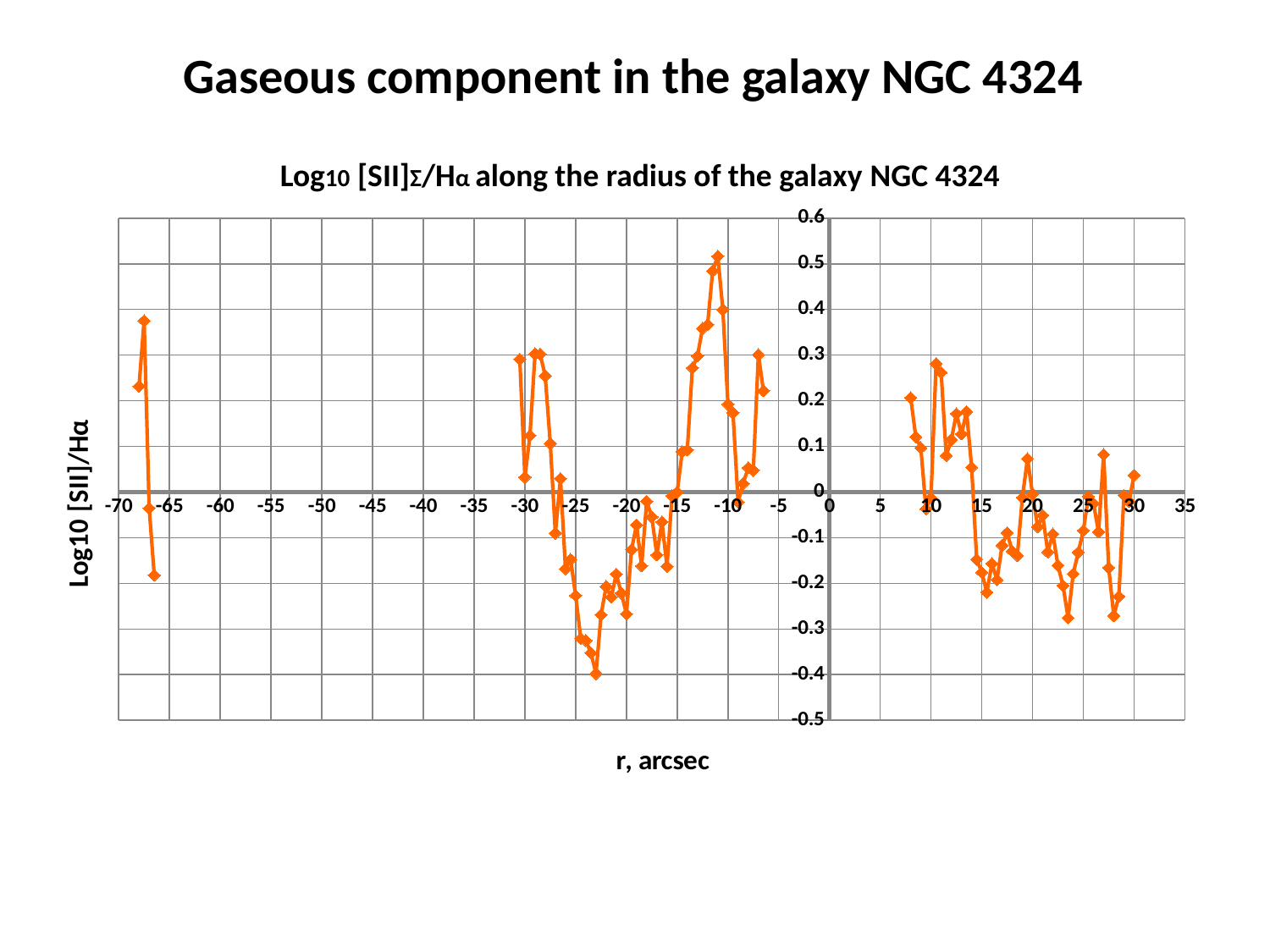
Is the highest value of the plotted line greater or less than 0.4? greater Do the values rise or fall as r goes from about -25 arcsec to about -11 arcsec? Rise Is the lowest value of the plotted line greater or less than -0.3? less What is the title of the chart? Log10 [SII]Σ/Hα along the radius of the galaxy NGC 4324 Which is larger: the peak of the line near r = -11 arcsec or the peak near r = 10 arcsec? The peak near r = -11 arcsec What kind of chart is shown on the slide? Line chart Is the value at r = 28 arcsec greater or less than -0.2? less What is the label of the x axis of the chart? r, arcsec Do the values rise or fall as r goes from about 10 arcsec to about 15 arcsec? Fall